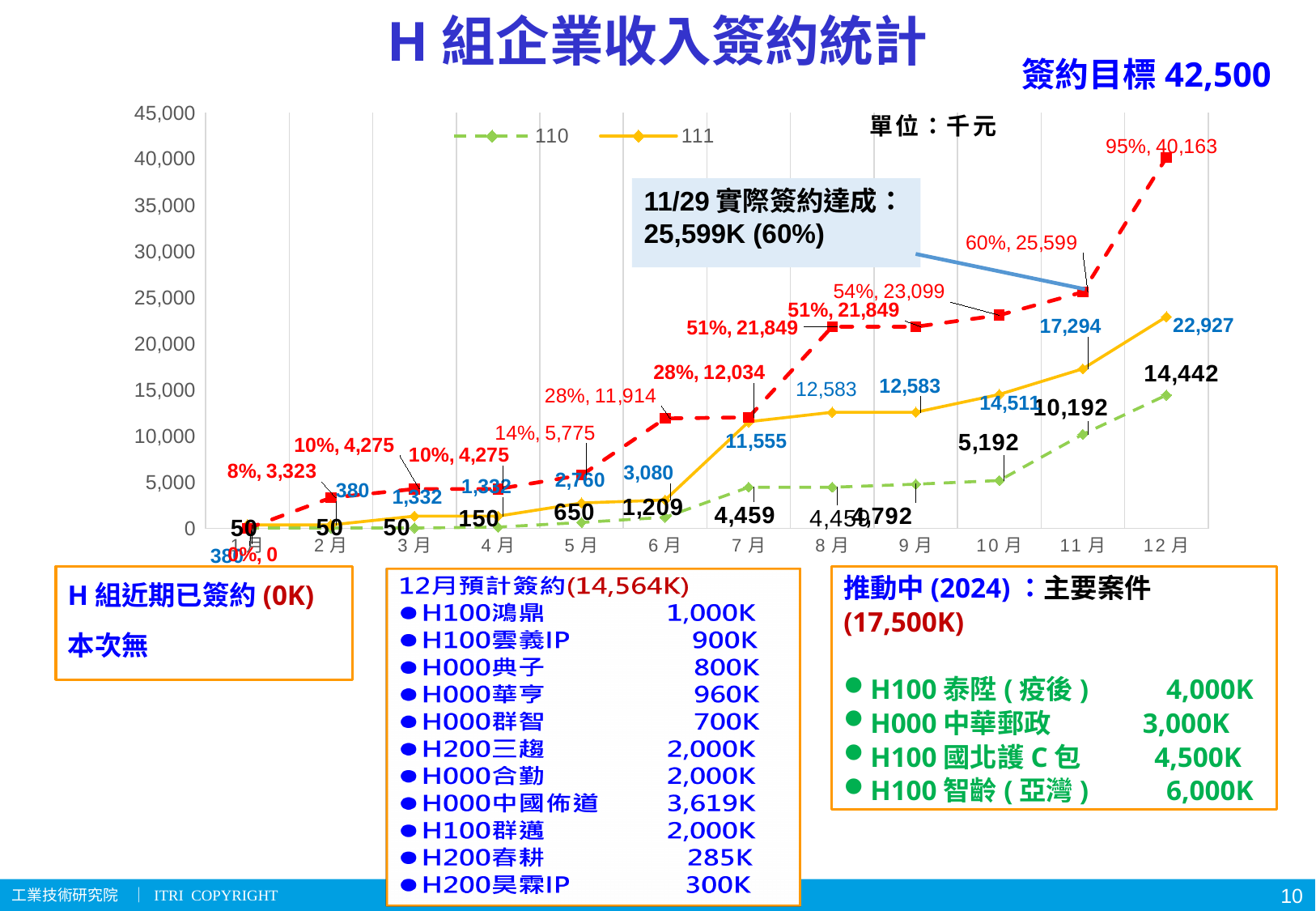
Does series 111 generally rise or fall from 1月 to 12月? rise What is the difference between series 111 and series 110 in 12月? 8,485 What is the value of series 111 in 12月? 22,927 How many months are shown along the x axis of the chart? 12 In 7月, which series has the larger value, 110 or 111? 111 What kind of chart is shown on the slide? line chart What is the value of series 110 in 12月? 14,442 What is the 簽約目標 (contract target) stated on the slide? 42,500 What is the value of series 111 in 11月? 17,294 What is the value labelled on the red dashed line in 12月? 95%, 40,163 What is the value of series 110 in 11月? 10,192 How many series does the chart's legend list? 2